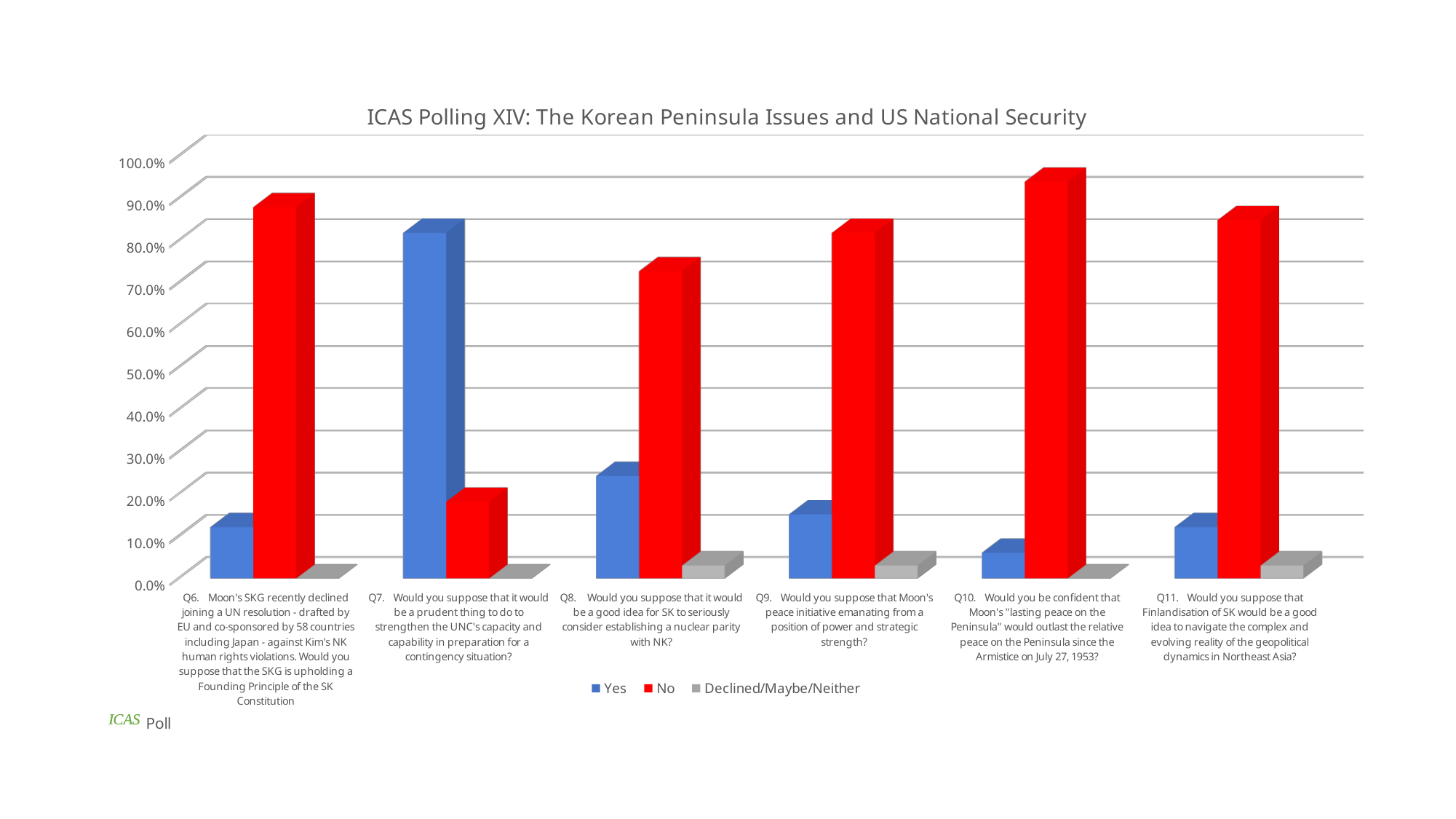
Which colour represents the "No" series in the chart? Red Is the "No" value for Q10 greater or less than 80.0%? greater Which question has the lowest "No" value? Q7 What kind of chart is shown on the slide? Bar chart How many survey questions (categories) are plotted on the chart? 6 Which question has the highest "No" value? Q10 Is the "Yes" value for Q7 greater or less than 70.0%? greater How many series does the legend list? 3 Is the "No" value for Q7 greater or less than 30.0%? less What is the title of the chart? ICAS Polling XIV: The Korean Peninsula Issues and US National Security For Q7, which is larger, the "Yes" value or the "No" value? Yes Which question has the highest "Yes" value? Q7